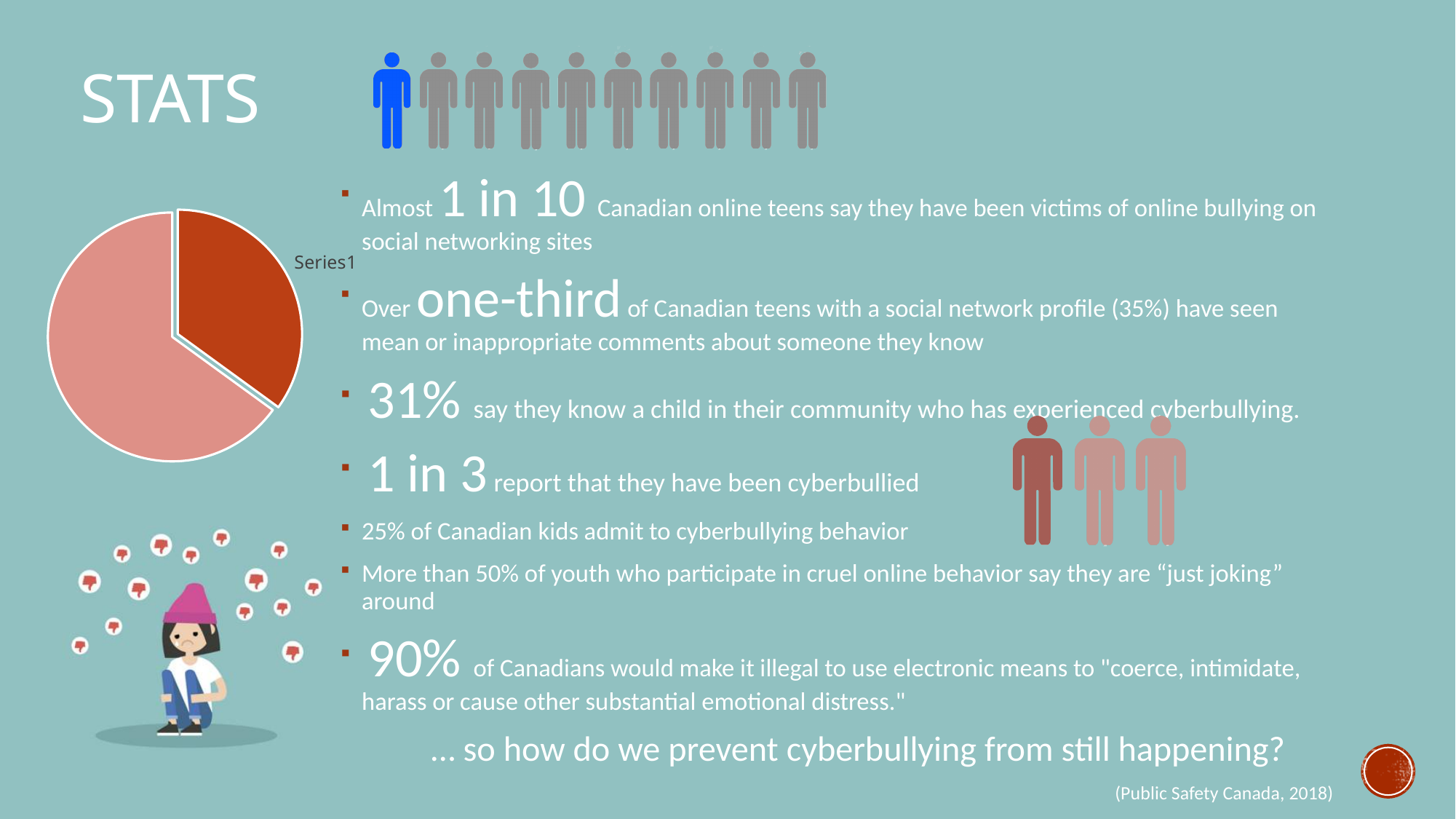
How many slices does the pie chart have? 2 What kind of chart is shown on the left of the slide? pie chart What label is printed next to the dark red slice of the pie chart? Series1 Which slice of the pie chart is larger, the dark red slice or the light pink slice? the light pink slice Which slice of the pie chart is the largest? the light pink slice Which slice of the pie chart is pulled out (exploded) from the rest of the pie? the dark red slice Which slice of the pie chart is the smallest? the dark red slice